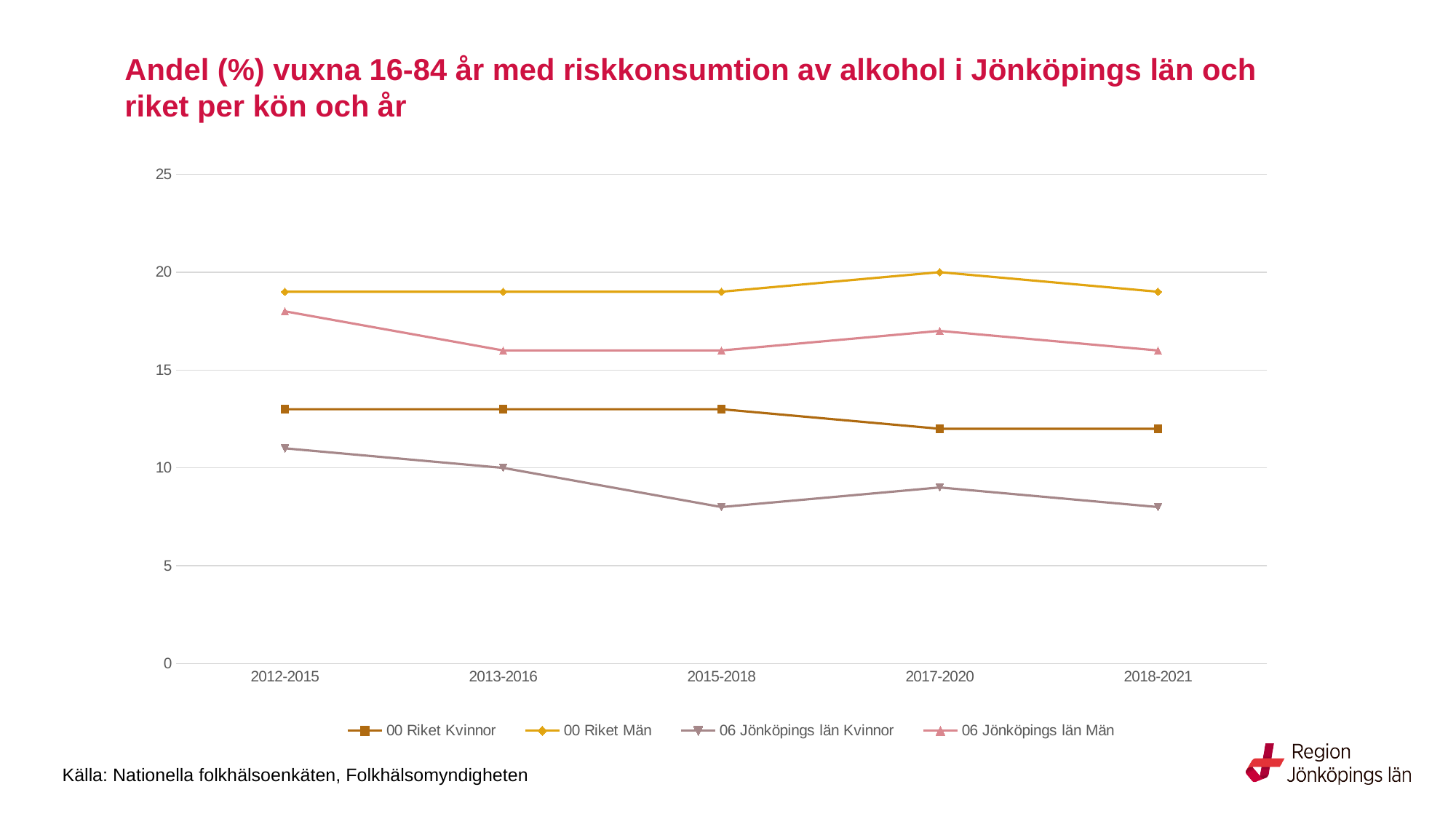
Is the value for 00 Riket Kvinnor in 2012-2015 greater or less than 15? less What kind of chart is shown on the slide? Line chart In 2018-2021, which is larger: 00 Riket Män or 06 Jönköpings län Män? 00 Riket Män How many series does the legend list? 4 Does the 06 Jönköpings län Kvinnor line rise or fall from 2012-2015 to 2015-2018? Fall What is the value for 00 Riket Män in 2017-2020? 20 How many time periods are shown on the x axis? 5 Is the value for 06 Jönköpings län Män in 2012-2015 greater or less than 15? greater Which series has the lowest value in 2015-2018? 06 Jönköpings län Kvinnor Which series has the highest value in 2017-2020? 00 Riket Män What source is cited below the chart? Nationella folkhälsoenkäten, Folkhälsomyndigheten What is the value for 06 Jönköpings län Kvinnor in 2013-2016? 10